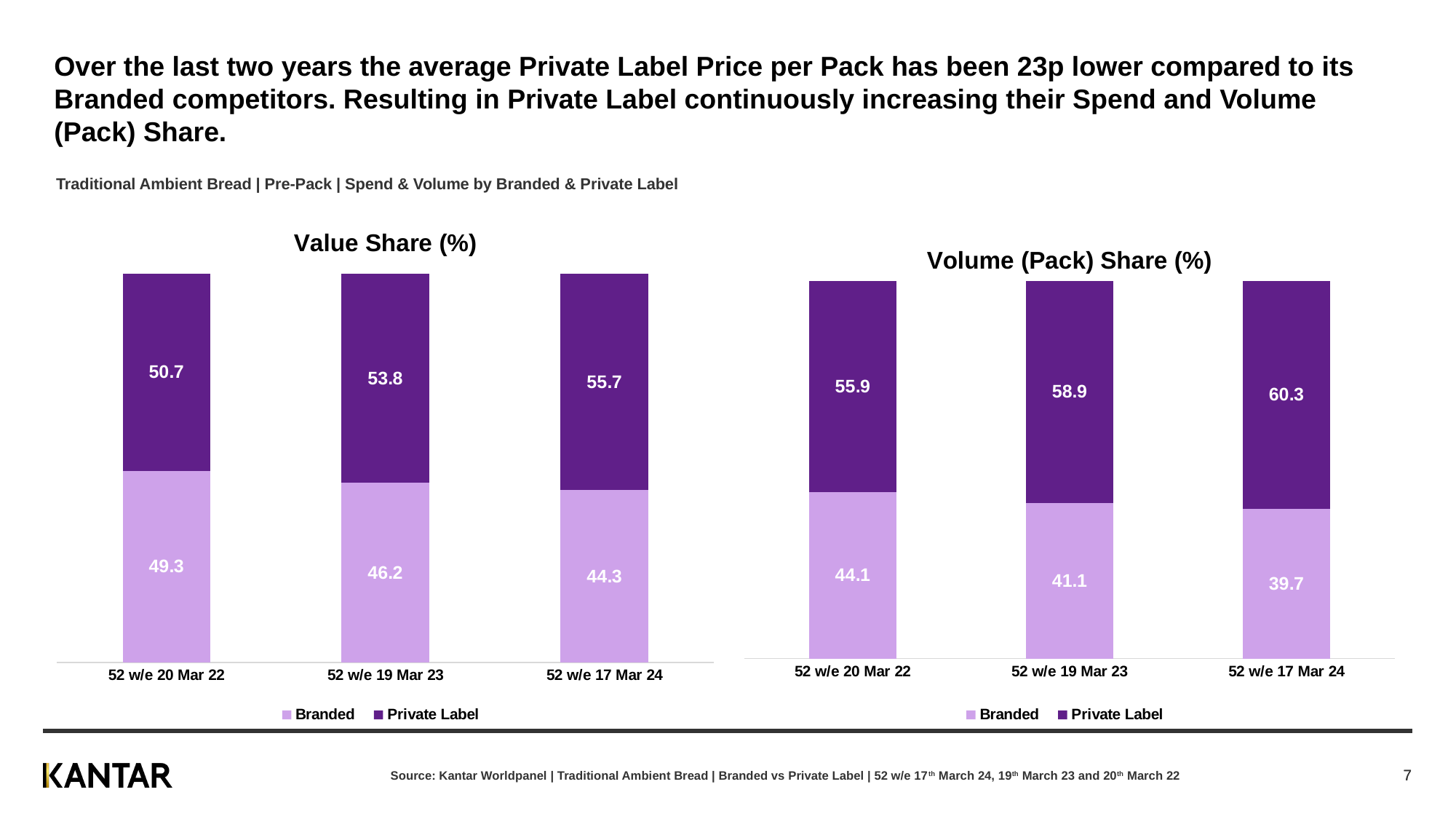
In the Value Share (%) chart, which period has the highest Private Label value? 52 w/e 17 Mar 24 In the Volume (Pack) Share (%) chart, which period has the lowest Branded value? 52 w/e 17 Mar 24 What kind of chart is the Value Share (%) chart? stacked bar chart In the Volume (Pack) Share (%) chart, what is the difference between the Private Label values for 52 w/e 17 Mar 24 and 52 w/e 20 Mar 22? 4.4 How many periods are shown on the x axis of the Volume (Pack) Share (%) chart? 3 In the Value Share (%) chart, what is the Branded value for 52 w/e 20 Mar 22? 49.3 In the Volume (Pack) Share (%) chart, which is larger for 52 w/e 20 Mar 22: Branded or Private Label? Private Label In the Volume (Pack) Share (%) chart, what is the Private Label value for 52 w/e 19 Mar 23? 58.9 In the Value Share (%) chart, does the Branded value rise or fall across the three periods? fall In the Volume (Pack) Share (%) chart, what is the Branded value for 52 w/e 17 Mar 24? 39.7 In the Value Share (%) chart, what is the difference between the Private Label and Branded values for 52 w/e 19 Mar 23? 7.6 In the Value Share (%) chart, what is the Private Label value for 52 w/e 17 Mar 24? 55.7